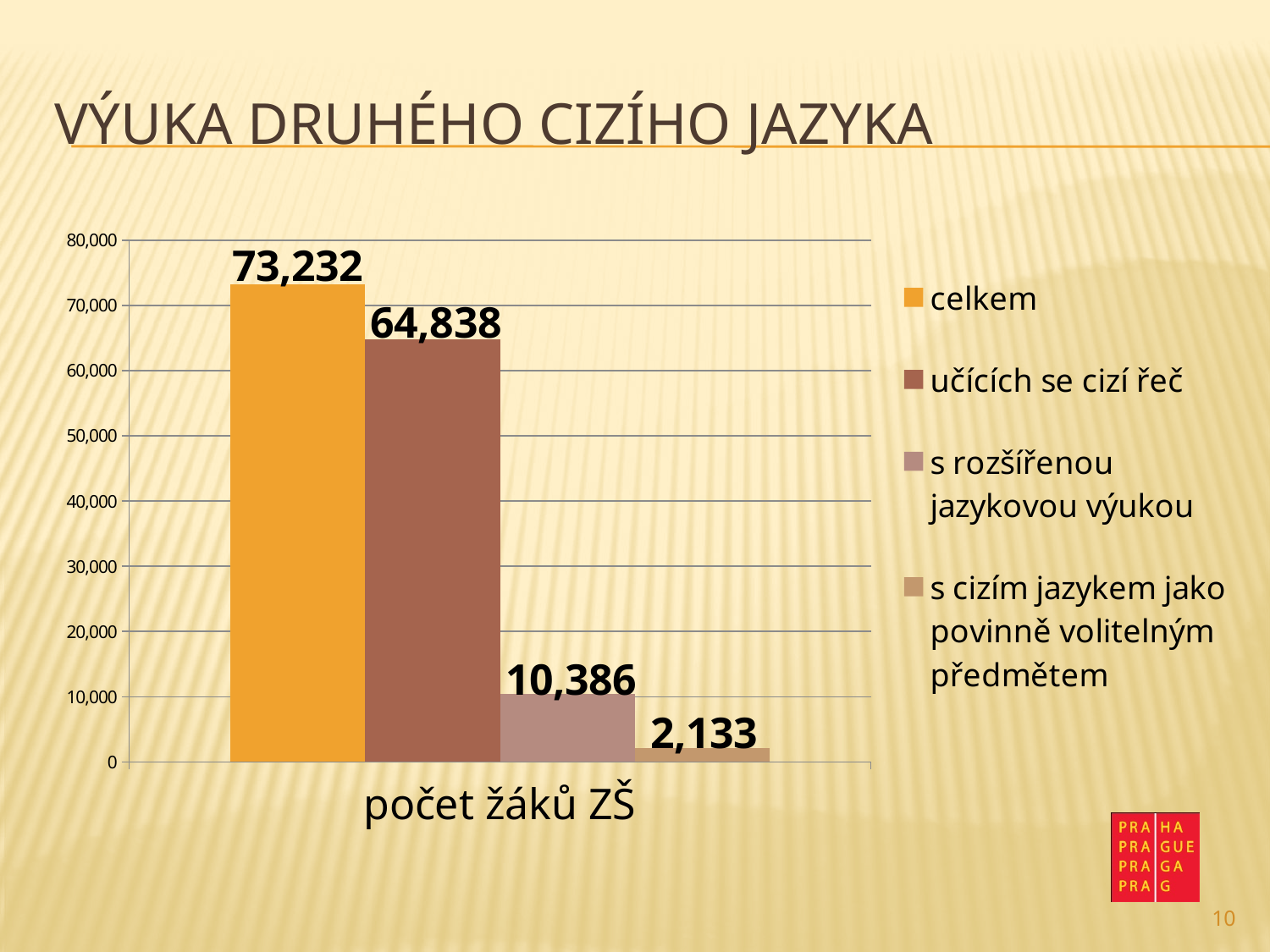
What is the category label shown on the x axis? počet žáků ZŠ What is the value for "celkem"? 73,232 What kind of chart is shown on the slide? bar chart Which series has the highest value? celkem What is the difference between "s rozšířenou jazykovou výukou" and "s cizím jazykem jako povinně volitelným předmětem"? 8,253 How many series does the legend list? 4 What is the difference between "celkem" and "učících se cizí řeč"? 8,394 Which is larger, "učících se cizí řeč" or "s rozšířenou jazykovou výukou"? učících se cizí řeč What is the value for "s cizím jazykem jako povinně volitelným předmětem"? 2,133 What is the value for "učících se cizí řeč"? 64,838 Which series has the lowest value? s cizím jazykem jako povinně volitelným předmětem What is the value for "s rozšířenou jazykovou výukou"? 10,386